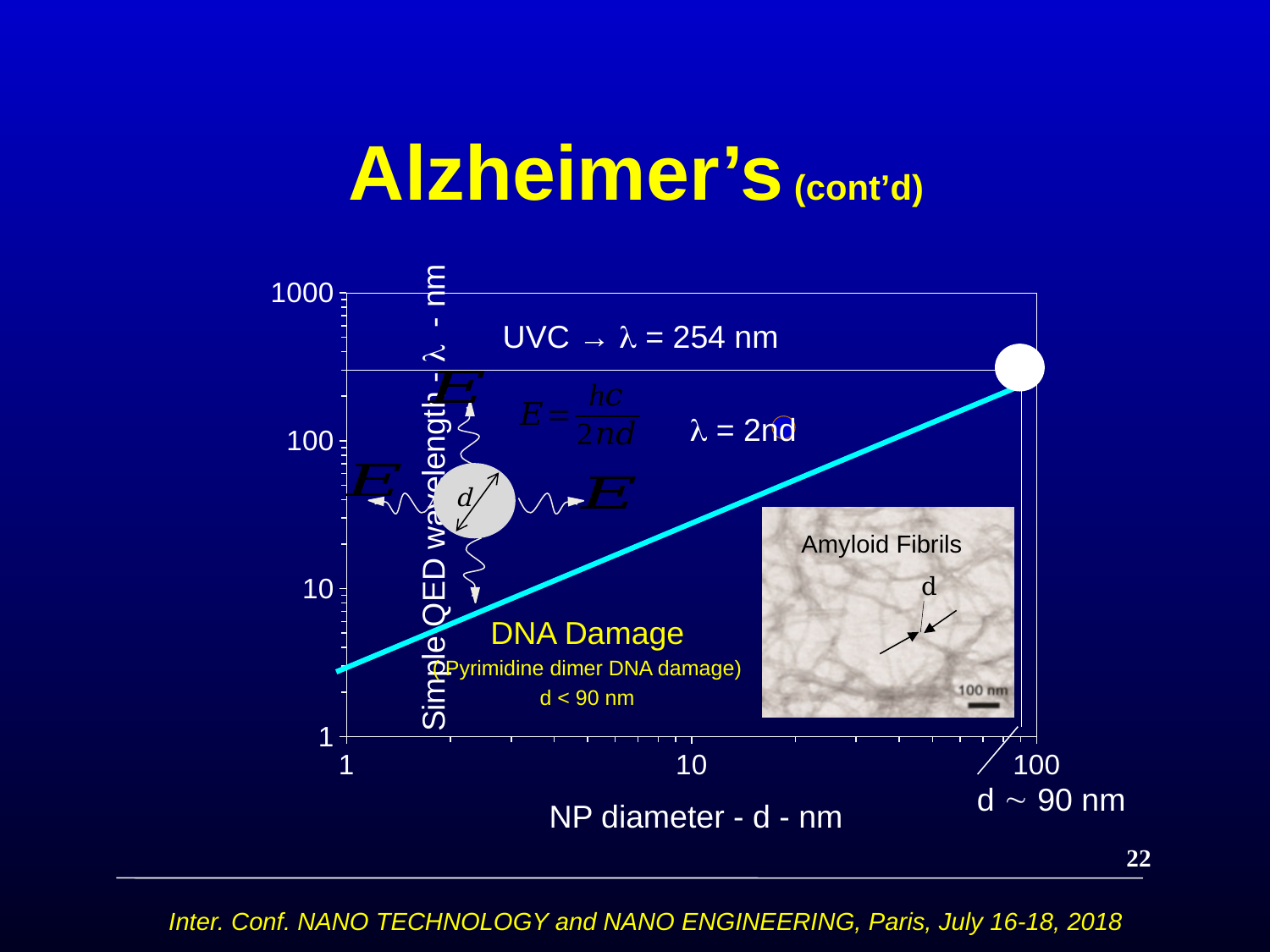
According to the annotation on the chart, what is the UVC wavelength λ? 254 nm What is the label of the y axis of the chart? Simple QED wavelength - λ - nm What is the highest tick value shown on the y axis of the chart? 1000 Does the plotted wavelength rise or fall as the NP diameter increases along the x axis? rises Is the plotted wavelength at an NP diameter of 10 nm greater or less than 100 nm? less What is the lowest tick value shown on the x axis of the chart? 1 How many data series (lines) are plotted on the chart? 1 What is the label of the x axis of the chart? NP diameter - d - nm Is the plotted wavelength at an NP diameter of 1 nm greater or less than 10 nm? less What kind of chart is shown on the slide? line chart Is the plotted wavelength at an NP diameter of 100 nm greater or less than 100 nm? greater